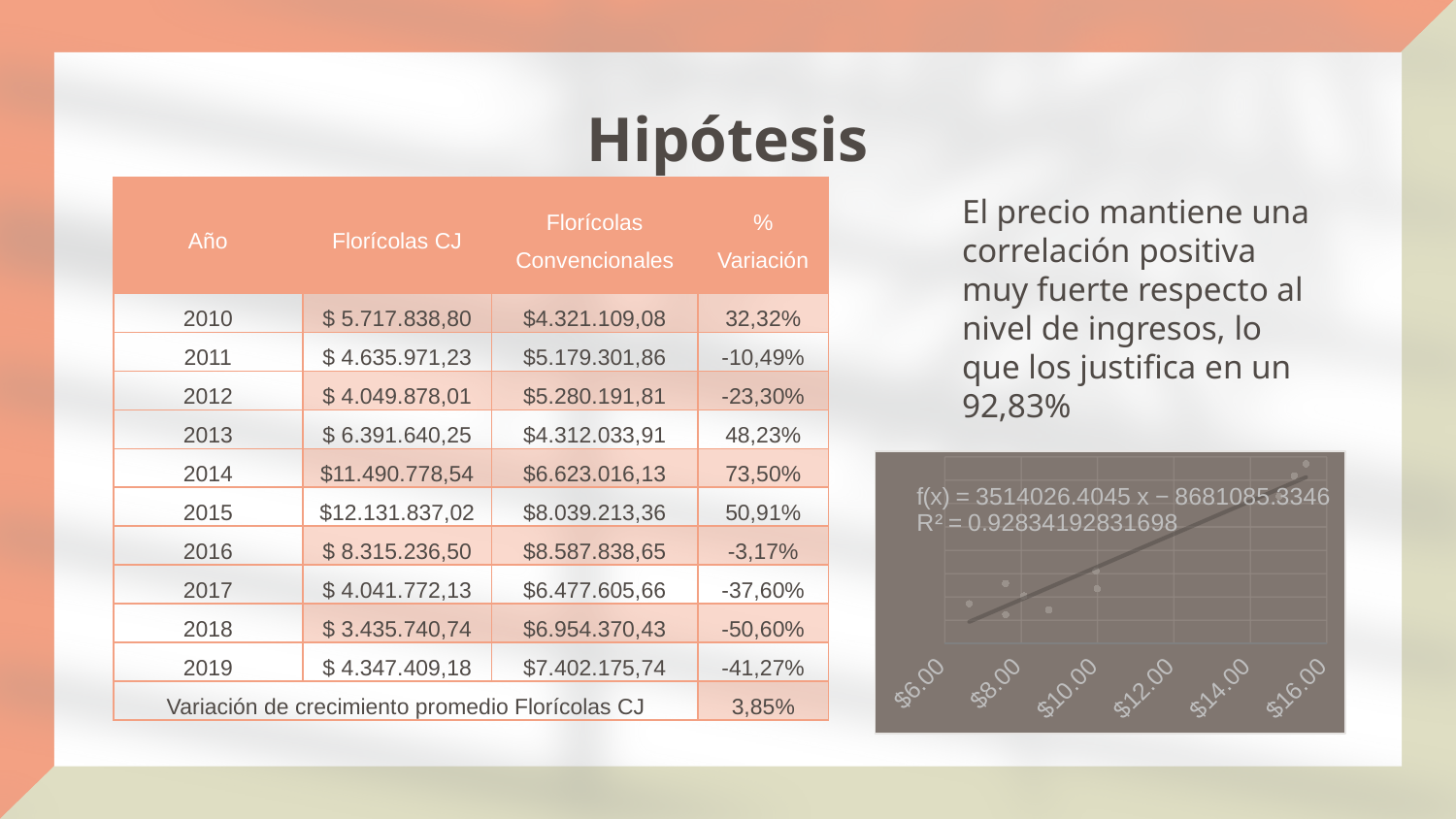
What is the highest tick label on the x-axis of the scatter chart? $16.00 What kind of chart is shown on the right side of the slide? scatter chart What R² value is printed on the scatter chart? 0.92834192831698 In the scatter chart, does the trendline rise or fall as the x-axis values increase? rise What is the lowest tick label on the x-axis of the scatter chart? $6.00 What trendline equation is printed on the scatter chart? f(x) = 3514026.4045 x − 8681085.3346 How many tick labels are shown on the x-axis of the scatter chart? 6 Is the slope of the trendline in the scatter chart positive or negative? positive